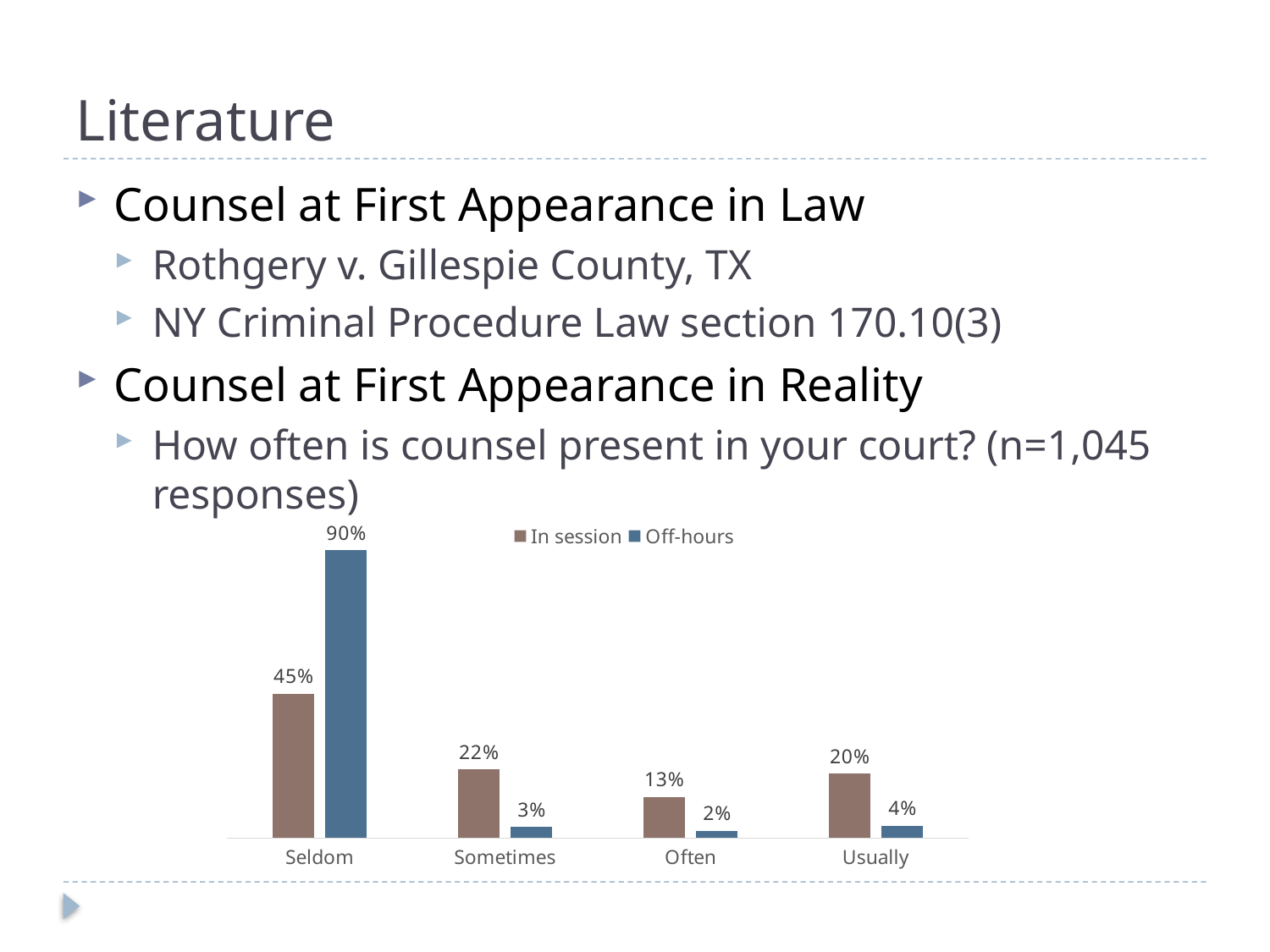
What kind of chart is shown on the slide? Bar chart What is the Off-hours value for Seldom? 90% How many categories are shown on the x axis? 4 Which is larger for Sometimes: In session or Off-hours? In session What are the two series named in the legend? In session and Off-hours What is the In session value for Seldom? 45% Which category has the highest Off-hours value? Seldom What is the difference between the Off-hours and In session values for Seldom? 45% Which category has the lowest In session value? Often What is the In session value for Usually? 20% What is the Off-hours value for Often? 2% How many series does the legend list? 2